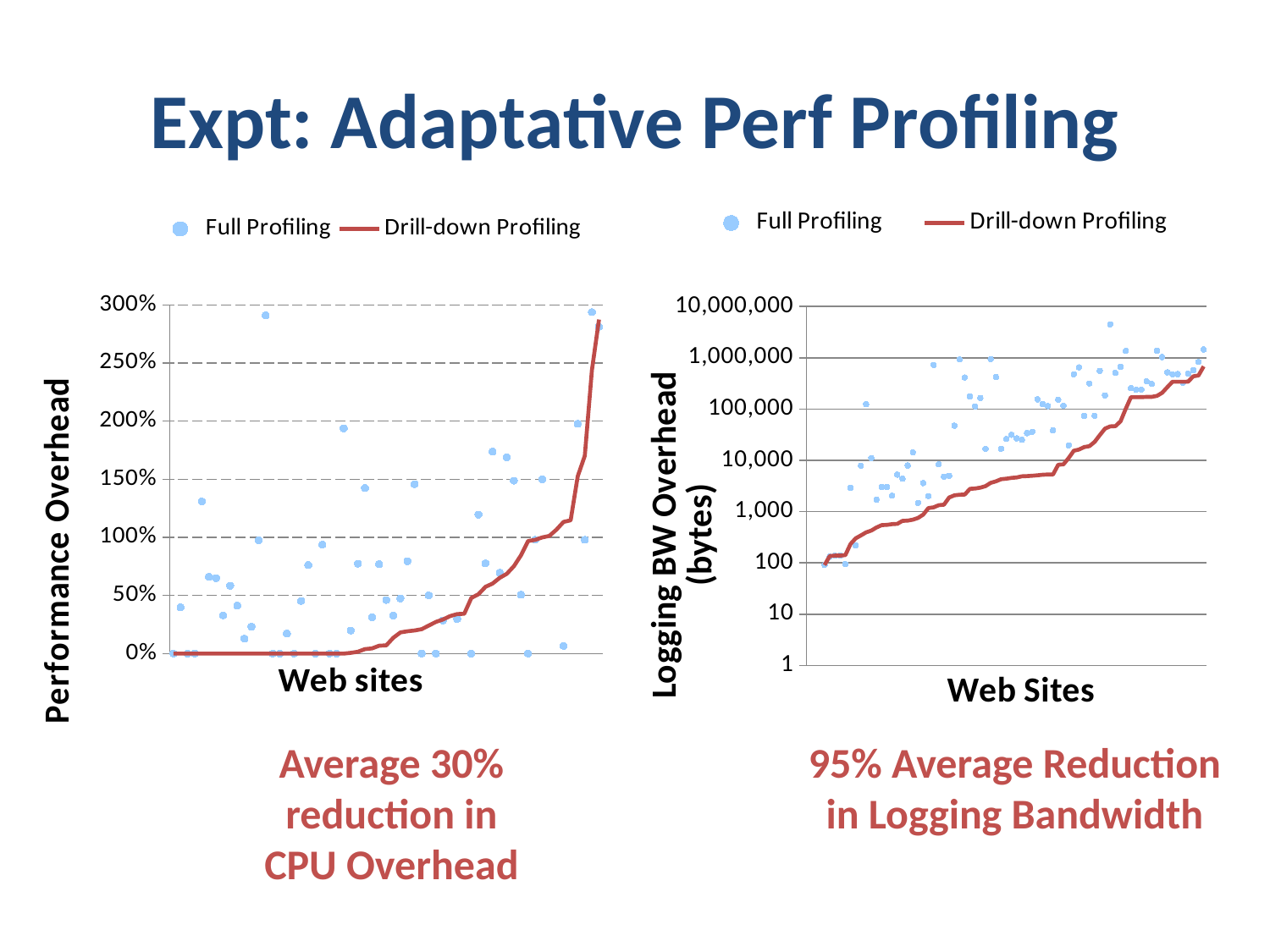
In the left chart (Performance Overhead), is the highest value reached by the Drill-down Profiling line greater or less than 250%? greater In the left chart (Performance Overhead), does the Drill-down Profiling line rise or fall from left to right along the x axis? rises How many charts are shown on the slide? 2 In the left chart (Performance Overhead), is the value of the Drill-down Profiling line for the leftmost web sites greater or less than 50%? less In the right chart (Logging BW Overhead), does the Drill-down Profiling line rise or fall from left to right along the x axis? rises In the right chart (Logging BW Overhead), is the final value of the Drill-down Profiling line at the rightmost web site greater or less than 100,000? greater What kind of chart is the left chart (Performance Overhead)? line chart What is the y-axis label of the left chart? Performance Overhead What are the two legend entries of the right chart (Logging BW Overhead)? Full Profiling and Drill-down Profiling How many series does the legend of the right chart (Logging BW Overhead) list? 2 How many series does the legend of the left chart (Performance Overhead) list? 2